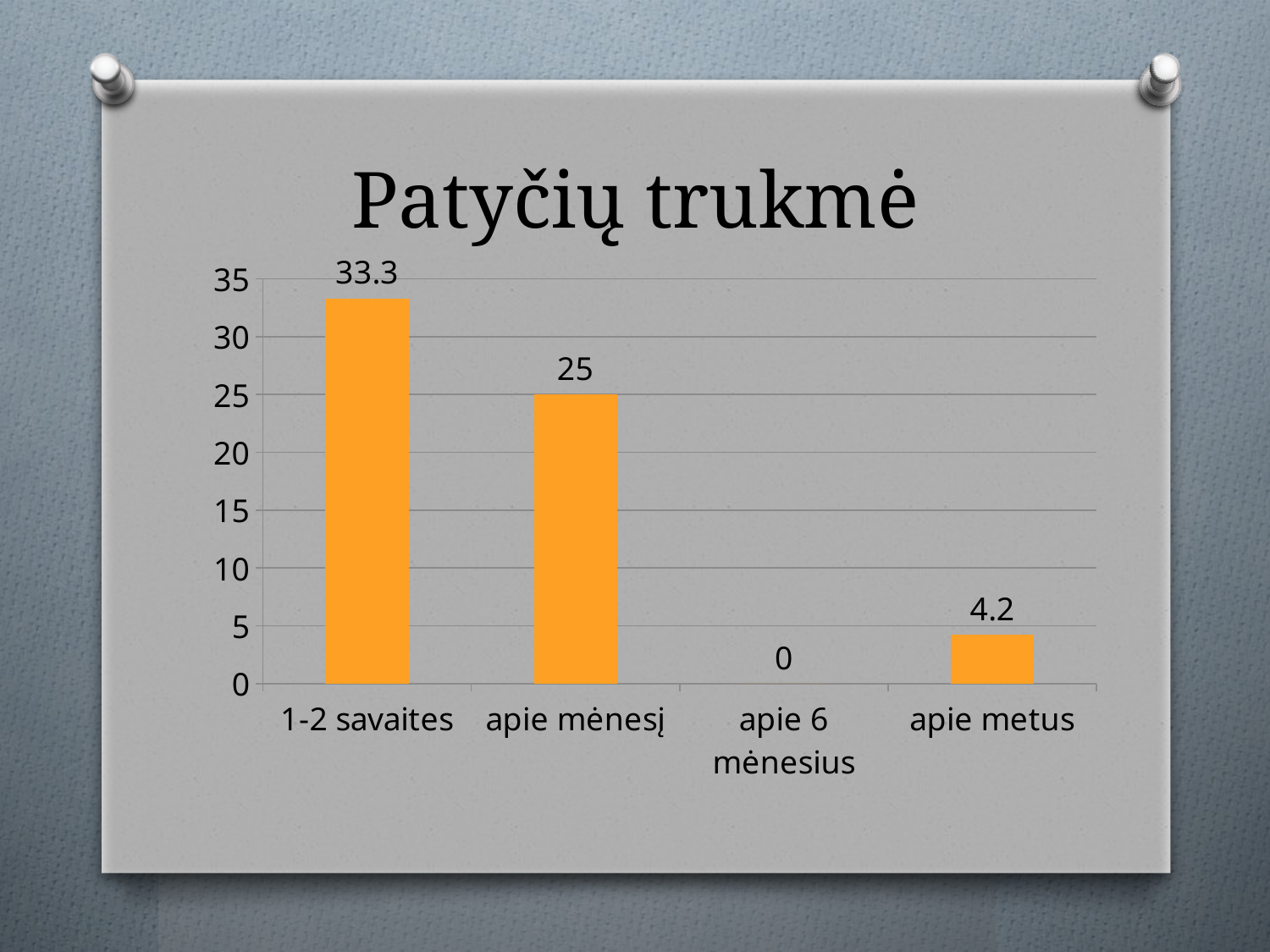
What is the value for "apie mėnesį"? 25 Which category has the highest value? 1-2 savaites What is the value for "apie 6 mėnesius"? 0 What is the title of the slide? Patyčių trukmė What is the value for "1-2 savaites"? 33.3 Which category has the lowest value? apie 6 mėnesius What is the difference between the values for "1-2 savaites" and "apie mėnesį"? 8.3 What is the value for "apie metus"? 4.2 Which is larger, the value for "apie mėnesį" or the value for "apie metus"? apie mėnesį Is the value for "apie metus" greater or less than 10? less How many categories are shown on the x axis? 4 What kind of chart is shown on the slide? bar chart